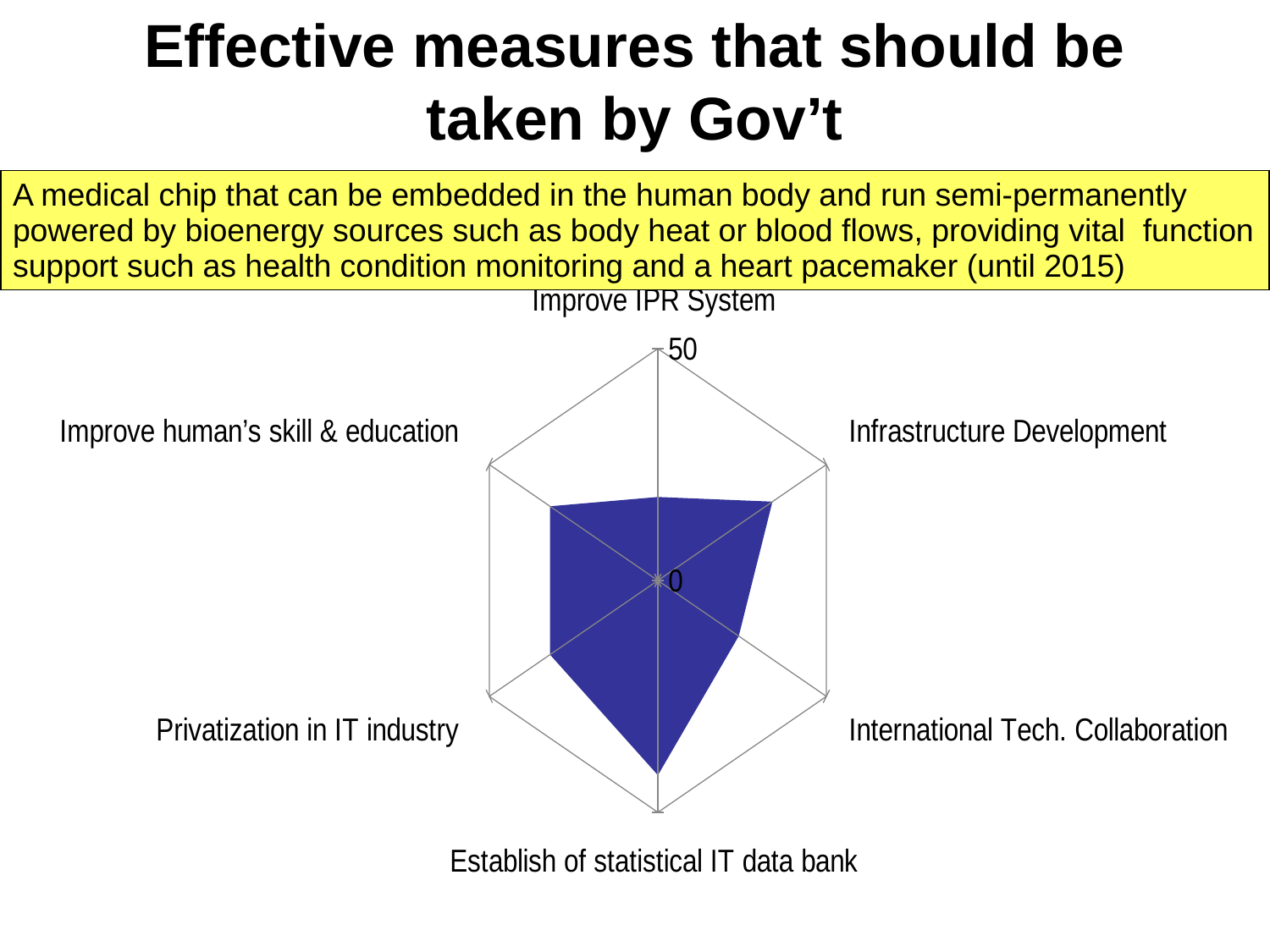
What kind of chart is shown on the slide? Radar chart What colour is the filled area of the radar chart? Blue What is the maximum value shown on the radar chart's axis scale? 50 Which is larger, the value for Infrastructure Development or the value for Improve IPR System? Infrastructure Development How many categories (axes) does the radar chart have? 6 Is the value for Infrastructure Development greater or less than 50? less Which is larger, the value for Establish of statistical IT data bank or the value for International Tech. Collaboration? Establish of statistical IT data bank Is the value for Improve IPR System greater or less than 50? less Which category has the highest value on the radar chart? Establish of statistical IT data bank Is the value for Establish of statistical IT data bank greater or less than 50? less Which is larger, the value for Establish of statistical IT data bank or the value for Improve IPR System? Establish of statistical IT data bank